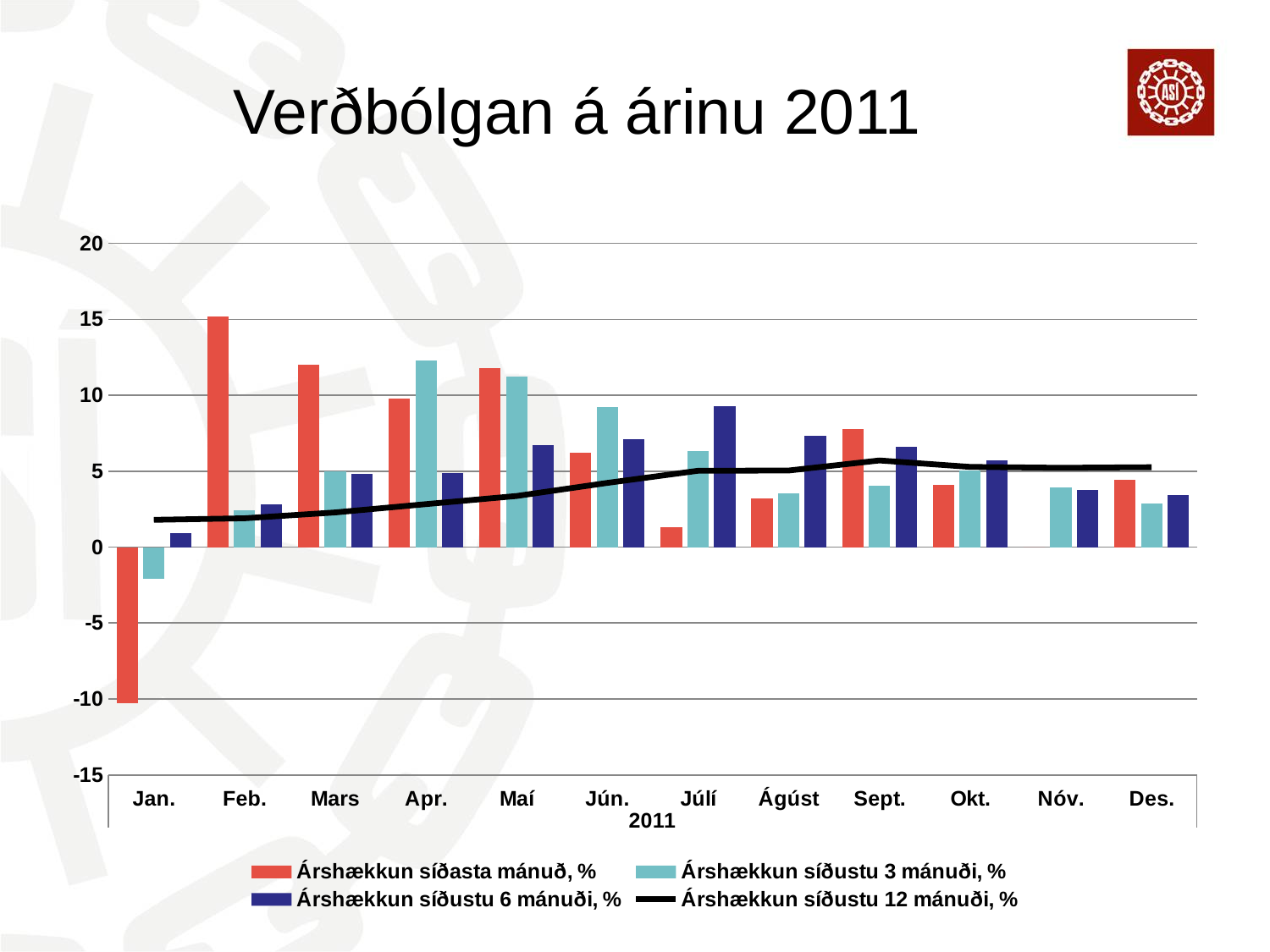
Which series is drawn as a black line rather than bars? Árshækkun síðustu 12 mánuði, % In which month is the value for Árshækkun síðasta mánuð, % lowest? Jan. In which month is the value for Árshækkun síðustu 6 mánuði, % highest? Júlí In which month is the value for Árshækkun síðustu 3 mánuði, % highest? Apr. Is the value for Árshækkun síðasta mánuð, % in Júlí greater or less than 5? less In which month is the value for Árshækkun síðasta mánuð, % highest? Feb. In Apr., which is larger: Árshækkun síðasta mánuð, % or Árshækkun síðustu 3 mánuði, %? Árshækkun síðustu 3 mánuði, % What is the title of the chart on the slide? Verðbólgan á árinu 2011 Is the value for Árshækkun síðasta mánuð, % in Mars greater or less than 10? greater How many months are shown along the x axis? 12 How many series does the legend list? 4 What kind of chart is shown on the slide? bar chart with a line